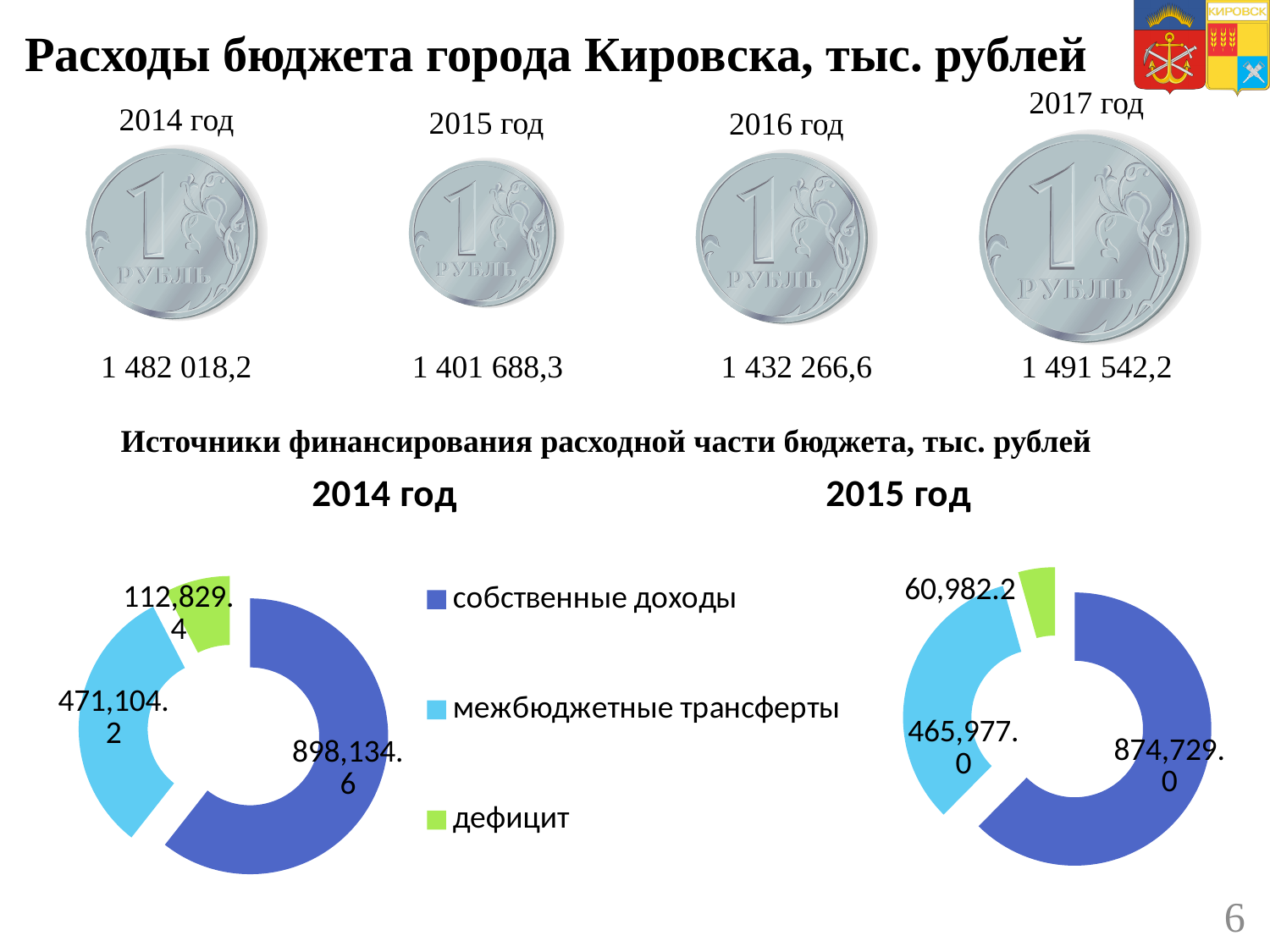
On the 2014 год chart, what is the value for межбюджетные трансферты? 471,104.2 On the 2014 год chart, what is the value for дефицит? 112,829.4 Which colour represents межбюджетные трансферты in the legend? light blue How many series does the legend list? 3 On the 2014 год chart, what is the value for собственные доходы? 898,134.6 On the 2014 год chart, what is the difference between собственные доходы and межбюджетные трансферты? 427,030.4 On the 2014 год chart, which category has the largest value? собственные доходы On the 2015 год chart, what is the value for дефицит? 60,982.2 On the 2015 год chart, which category has the smallest value? дефицит On the 2015 год chart, what is the value for собственные доходы? 874,729.0 What kind of chart is used for the 2015 год data? doughnut chart Is the дефицит value larger on the 2014 год chart or the 2015 год chart? 2014 год